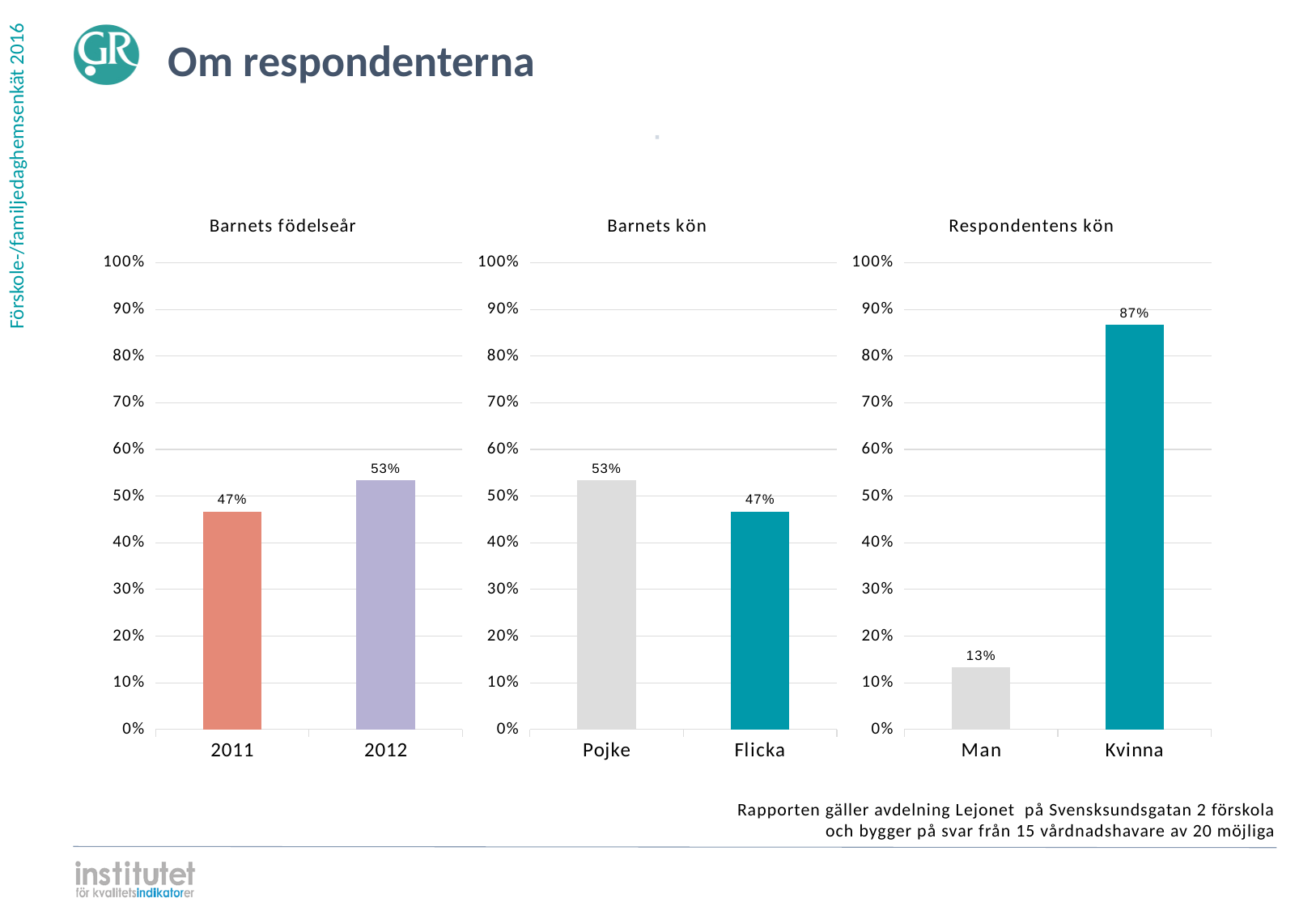
In the 'Respondentens kön' chart, which category has the highest value? Kvinna In the 'Respondentens kön' chart, what is the value for Kvinna? 87% In the 'Barnets kön' chart, which category has the lowest value? Flicka In the 'Barnets födelseår' chart, what is the value for 2012? 53% What kind of chart is the 'Respondentens kön' chart? Bar chart In the 'Barnets kön' chart, what is the value for Pojke? 53% In the 'Barnets kön' chart, how many categories are shown? 2 In the 'Respondentens kön' chart, what is the value for Man? 13% In the 'Barnets födelseår' chart, what is the value for 2011? 47% In the 'Respondentens kön' chart, what is the difference between the values for Kvinna and Man? 74% How many charts are shown on the slide? 3 In the 'Barnets födelseår' chart, which is larger, the value for 2011 or 2012? 2012